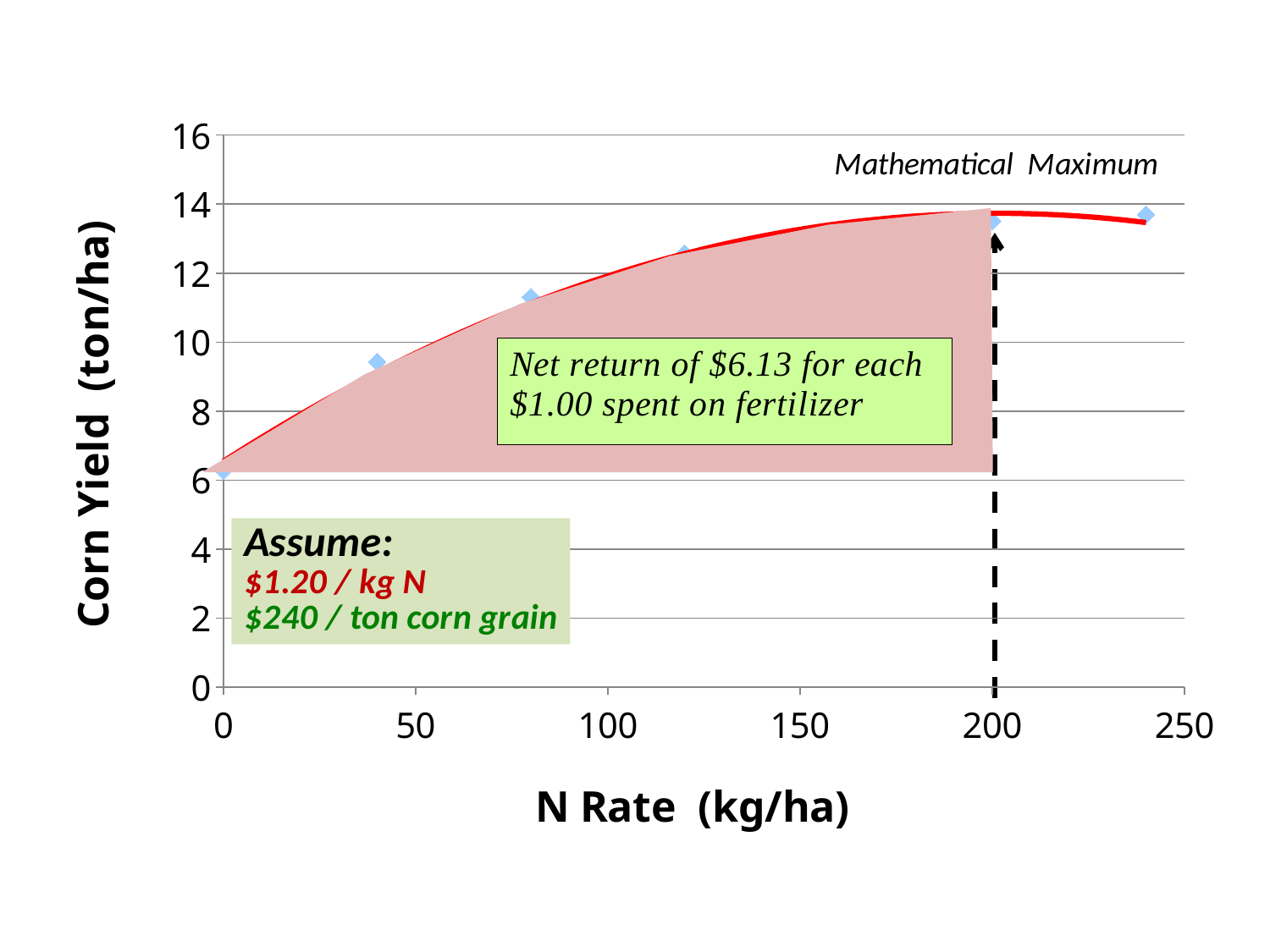
What is the label of the y axis? Corn Yield (ton/ha) Which has the higher corn yield: an N rate of 40 kg/ha or 80 kg/ha? 80 kg/ha What is the highest value shown on the y axis? 16 What is the label of the x axis? N Rate (kg/ha) What kind of chart is shown on the slide? Scatter plot with a fitted curve Is the corn yield at an N rate of 40 kg/ha greater or less than 8 ton/ha? greater Is the corn yield at an N rate of 240 kg/ha greater or less than 14 ton/ha? less Is the corn yield at an N rate of 80 kg/ha greater or less than 10 ton/ha? greater At which N rate is the corn yield lowest? 0 Does corn yield generally rise or fall as N rate increases from 0 to 200 kg/ha? Rise